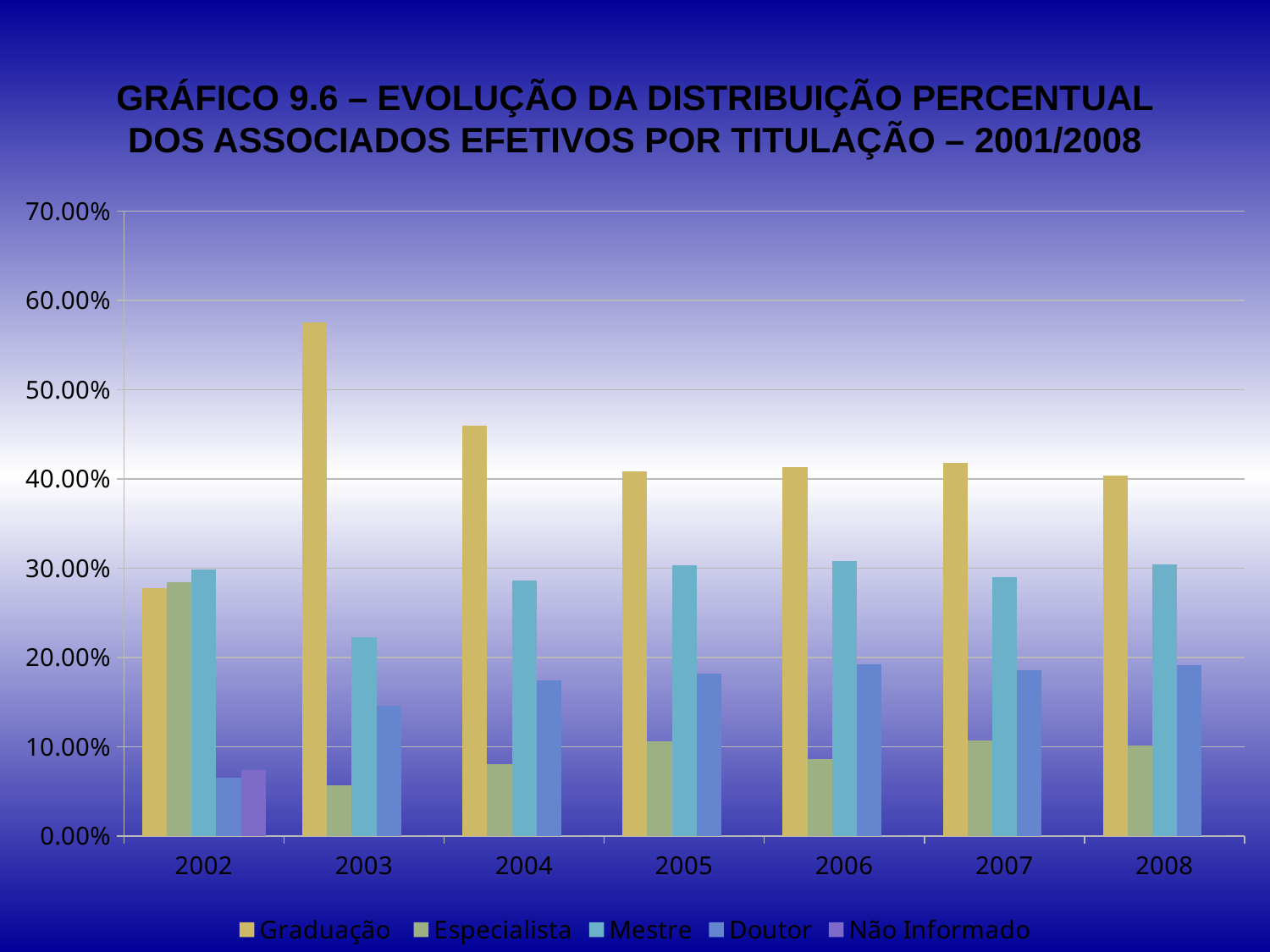
Does the Graduação value rise or fall from 2003 to 2004? fall Which is larger: Graduação in 2004 or Graduação in 2005? Graduação in 2004 Is the value for Especialista in 2003 greater or less than 10.00%? less In which year is the Graduação bar the lowest? 2002 What kind of chart is shown on the slide? bar chart In which year is the Graduação bar the highest? 2003 Is the value for Graduação in 2003 greater or less than 50.00%? greater How many series does the legend list? 5 How many years are shown on the x axis? 7 Is the value for Doutor in 2004 greater or less than 20.00%? less In 2002, which is larger: Mestre or Doutor? Mestre